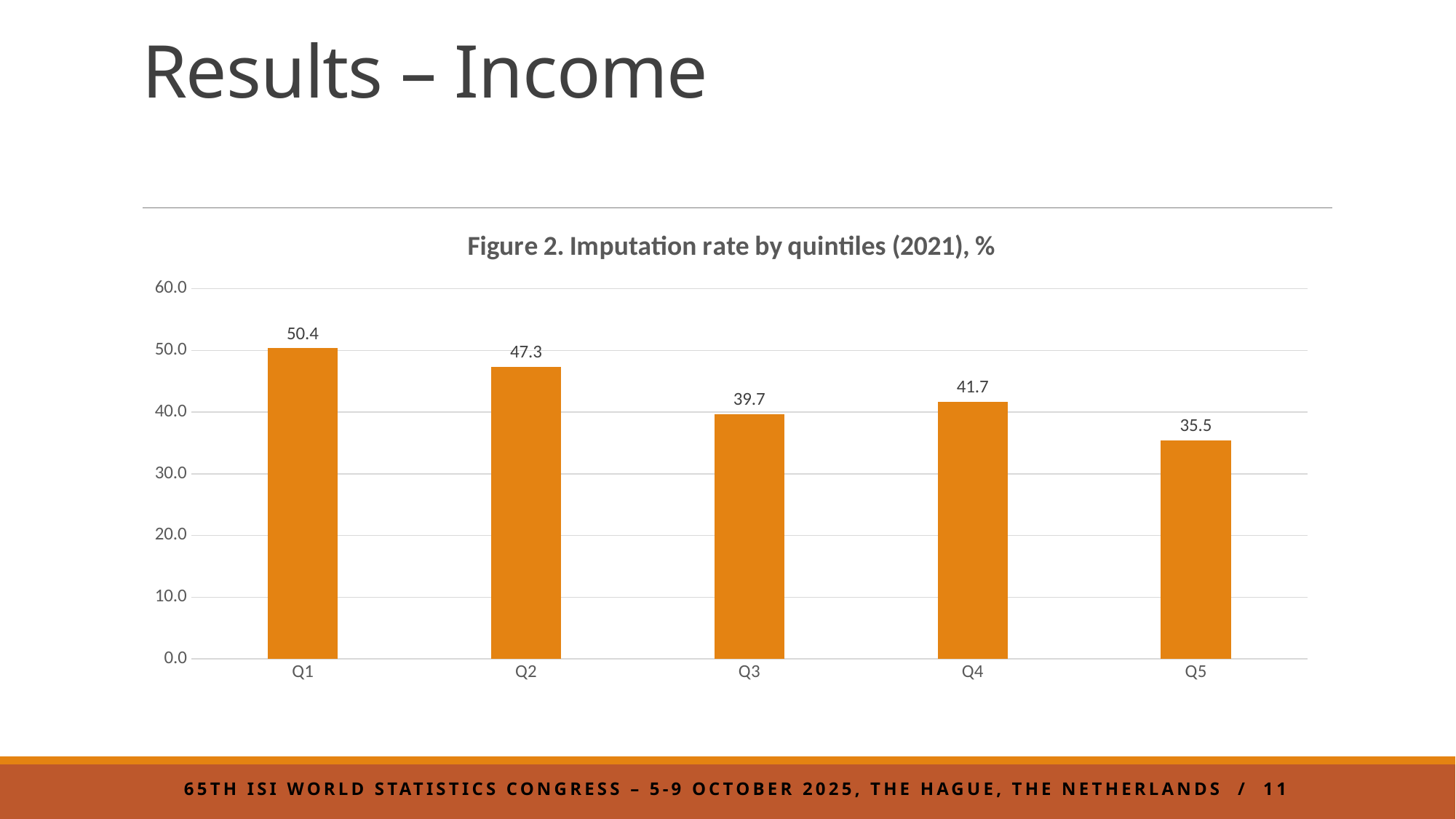
What is the difference between the imputation rates for Q4 and Q3? 2.0 Which quintile has the highest imputation rate? Q1 What kind of chart is shown on the slide? Bar chart What is the difference between the imputation rates for Q1 and Q5? 14.9 Which has a higher imputation rate, Q2 or Q4? Q2 Which quintile has the lowest imputation rate? Q5 What is the imputation rate for Q3? 39.7 What is the imputation rate for Q5? 35.5 What is the title of the chart? Figure 2. Imputation rate by quintiles (2021), % What is the imputation rate for Q1? 50.4 How many quintiles are shown on the x axis? 5 Is the value for Q2 greater or less than 40.0? greater